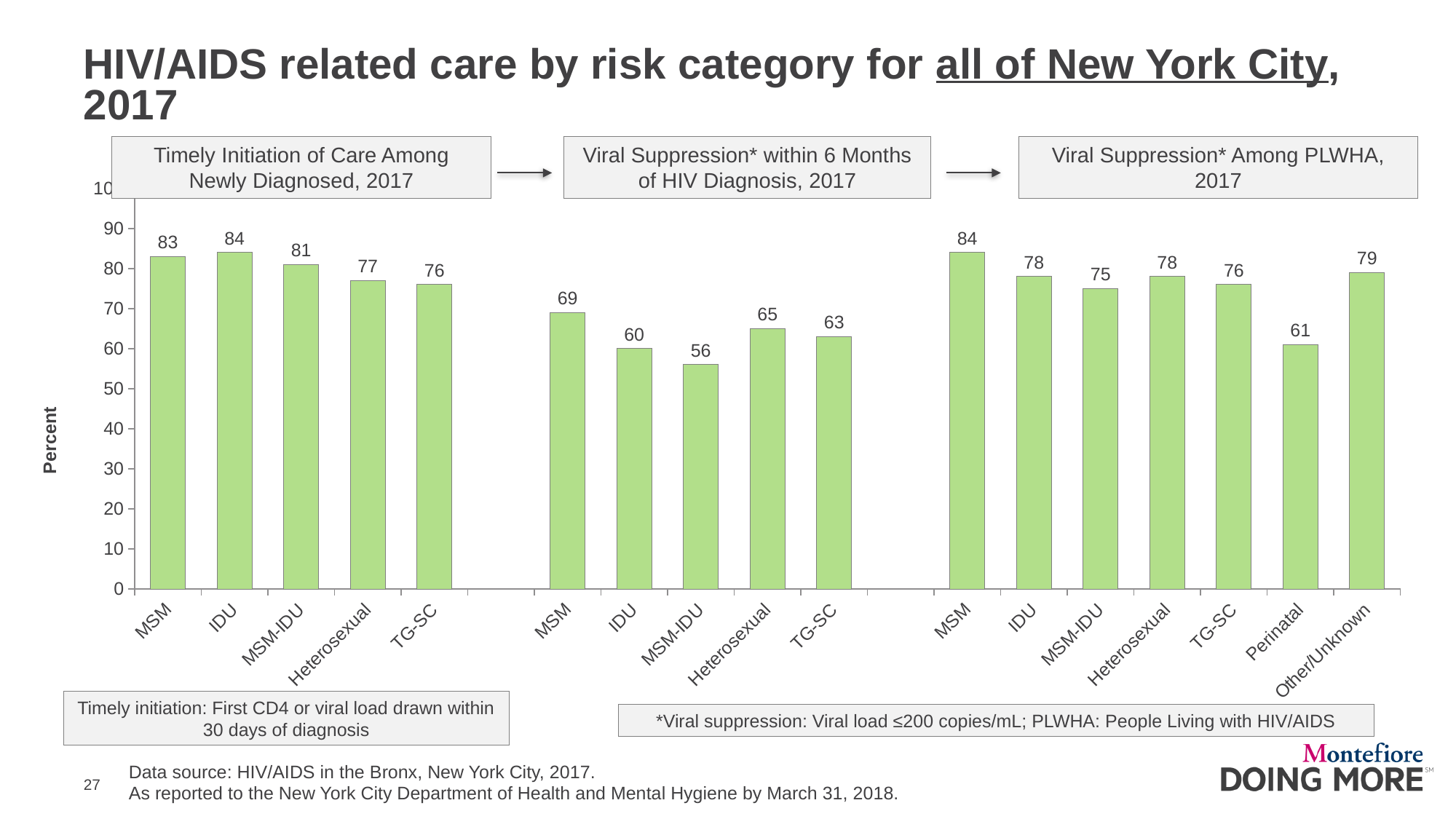
What is the difference between the MSM value in the Timely Initiation of Care group and the MSM value in the Viral Suppression within 6 Months group? 14 What is the label of the vertical axis? Percent What is the value for Heterosexual in the Viral Suppression within 6 Months of HIV Diagnosis group? 65 How many bars are plotted on the chart in total? 17 How many risk categories are shown in the Viral Suppression Among PLWHA group? 7 What is the value for Perinatal in the Viral Suppression Among PLWHA group? 61 Which risk category has the lowest value in the Timely Initiation of Care Among Newly Diagnosed group? TG-SC What is the value for MSM-IDU in the Timely Initiation of Care Among Newly Diagnosed group? 81 Which risk category has the highest value in the Viral Suppression Among PLWHA group? MSM What kind of chart is shown on the slide? Bar chart Which is larger: the IDU value in the Viral Suppression within 6 Months group or the IDU value in the Viral Suppression Among PLWHA group? Viral Suppression Among PLWHA Which risk category has the lowest value in the Viral Suppression within 6 Months of HIV Diagnosis group? MSM-IDU